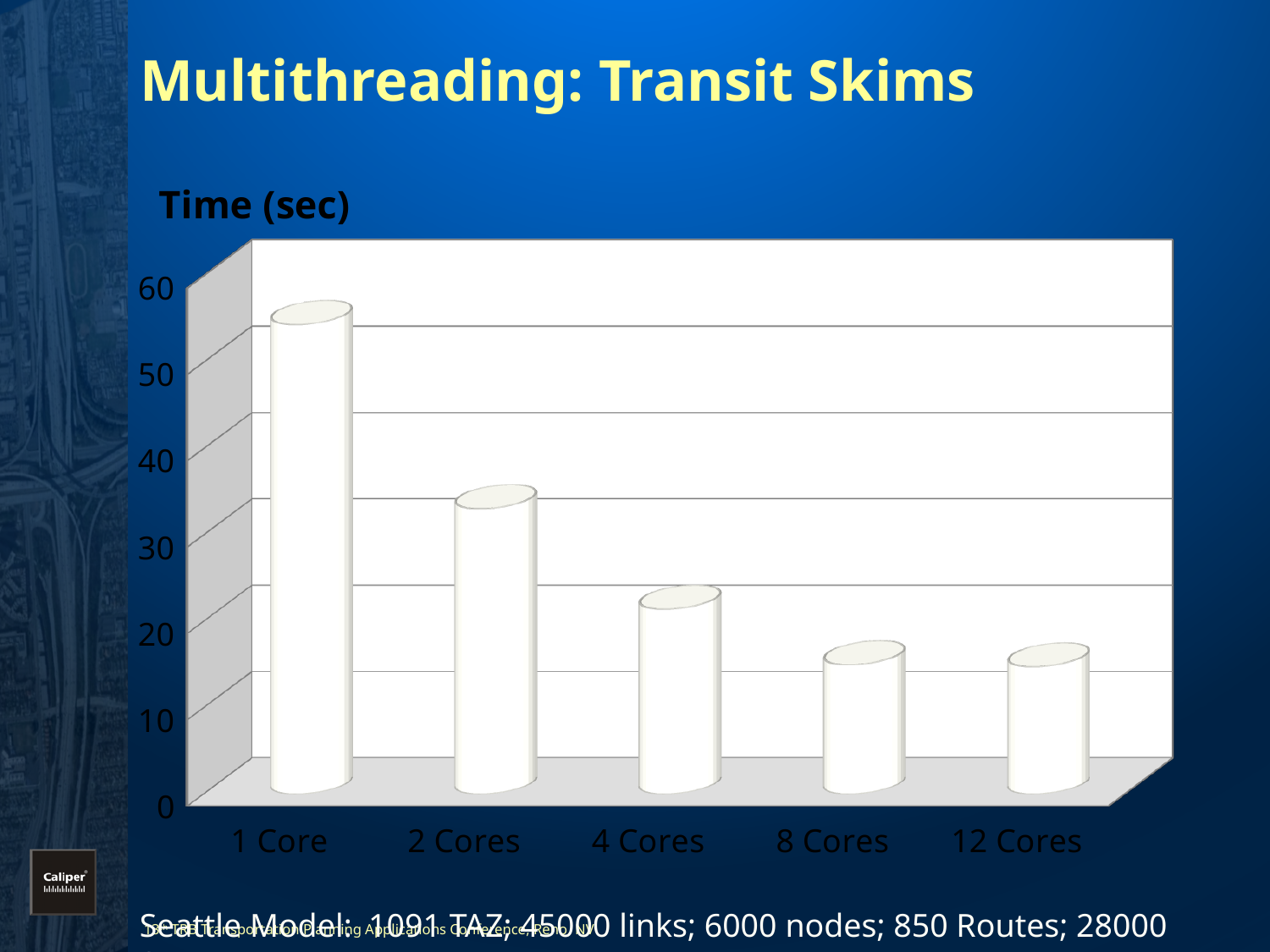
Do the values rise or fall as the number of cores increases along the x axis? fall Is the value for 12 Cores greater or less than 10? greater Is the value for 2 Cores greater or less than 30? greater Is the value for 8 Cores greater or less than 20? less What type of chart is shown on the slide? bar chart Which is larger, the value for 2 Cores or the value for 4 Cores? 2 Cores How many categories are shown on the x axis of the chart? 5 Which category has the highest value in the chart? 1 Core What is the title of the chart? Time (sec)